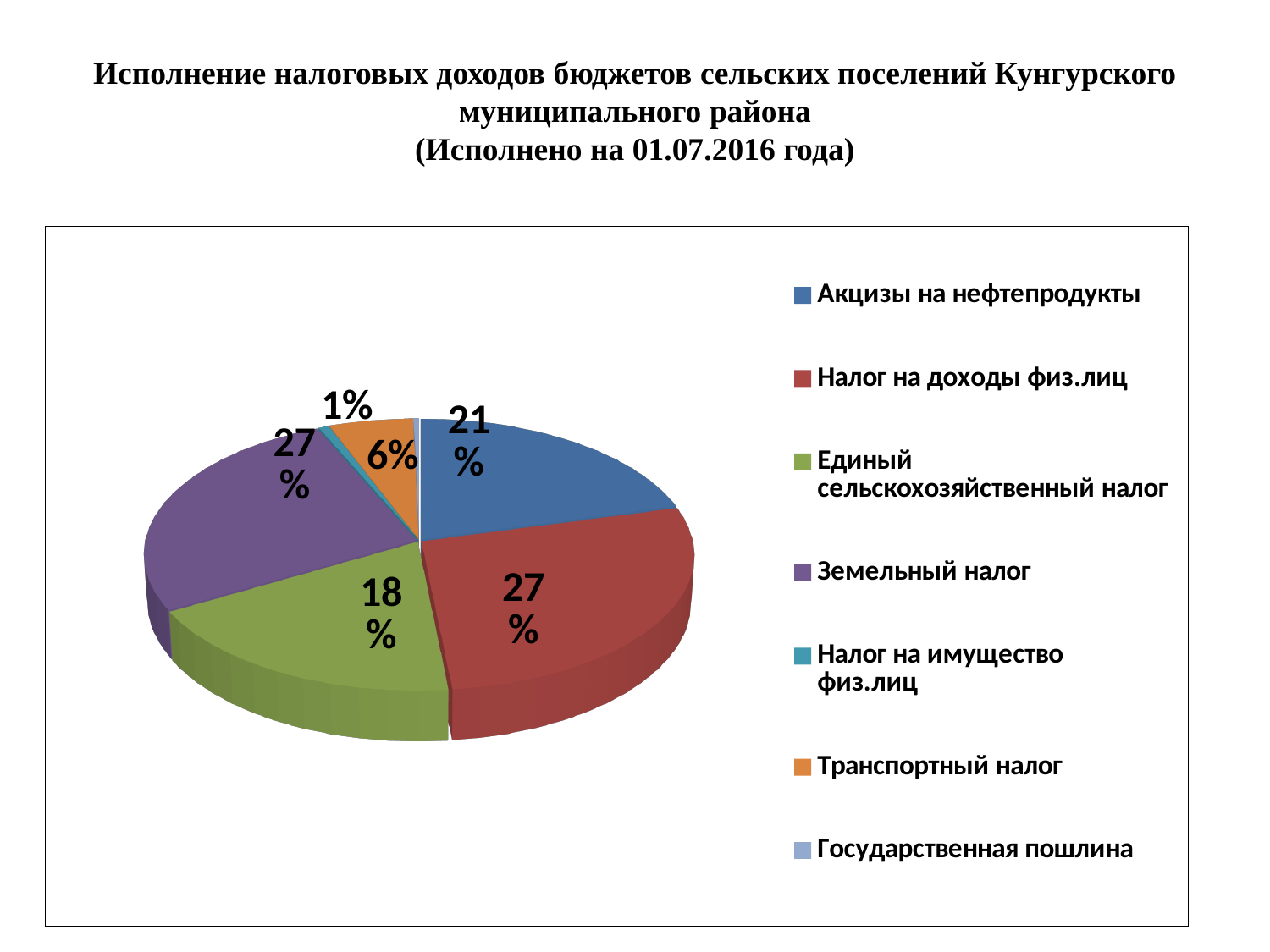
What is the difference in percentage points between Налог на доходы физ.лиц and Акцизы на нефтепродукты? 6 How many categories does the legend list? 7 As of what date is the data on the slide reported (per the title)? 01.07.2016 What share of the pie does Единый сельскохозяйственный налог represent? 18% What share of the pie does Земельный налог represent? 27% What share of the pie does Акцизы на нефтепродукты represent? 21% Which is larger: the share for Единый сельскохозяйственный налог or the share for Транспортный налог? Единый сельскохозяйственный налог What kind of chart is shown on the slide? Pie chart What colour is the slice for Земельный налог? Purple What share of the pie does Транспортный налог represent? 6% What share of the pie does Налог на доходы физ.лиц represent? 27% What share of the pie does Налог на имущество физ.лиц represent? 1%